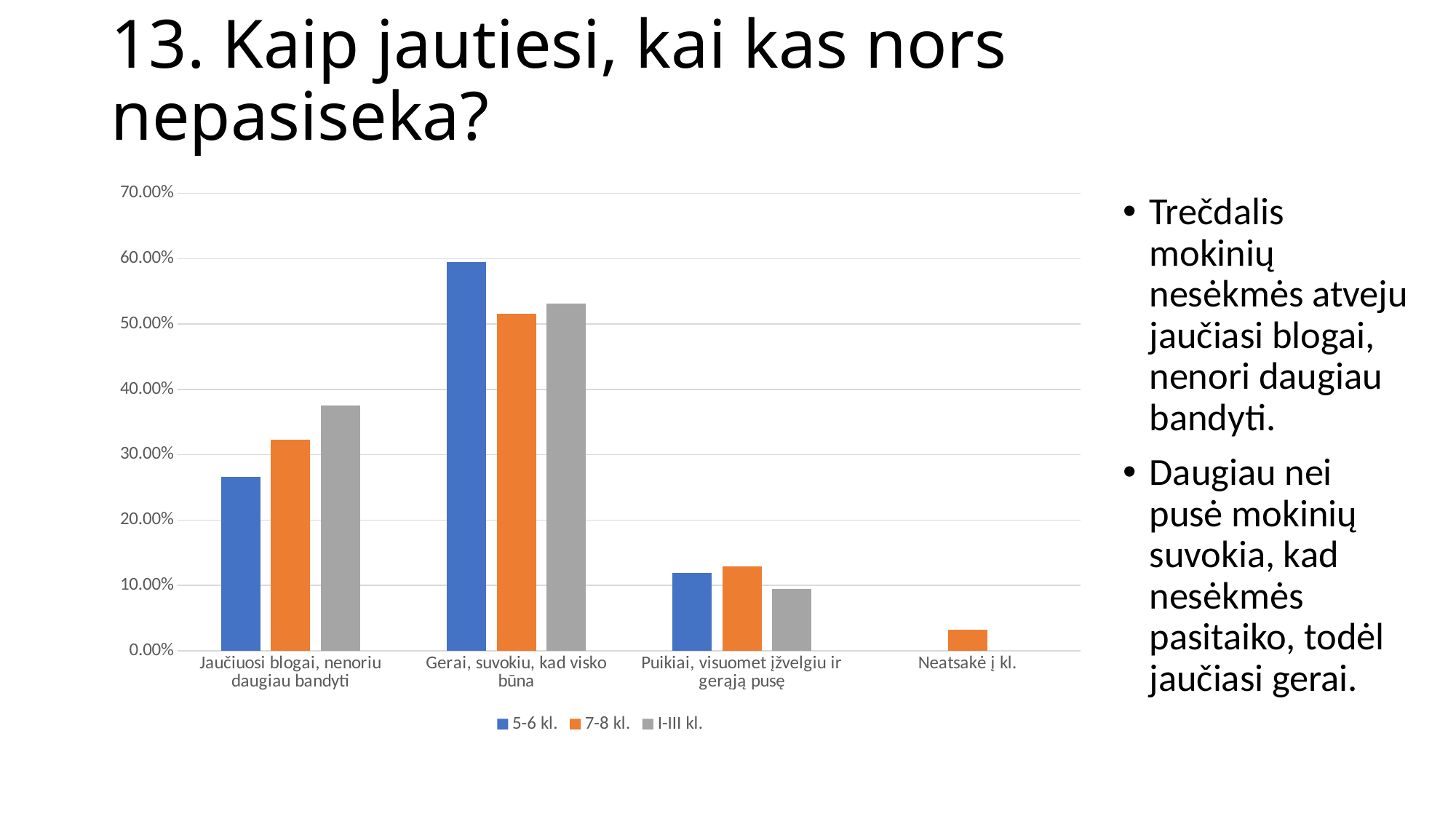
Is the value for 7-8 kl. in the category "Jaučiuosi blogai, nenoriu daugiau bandyti" greater or less than 30.00%? greater Is the value for I-III kl. in the category "Jaučiuosi blogai, nenoriu daugiau bandyti" greater or less than 40.00%? less How many series does the legend list? 3 How many categories are shown on the x axis? 4 Is the value for 5-6 kl. in the category "Gerai, suvokiu, kad visko būna" greater or less than 50.00%? greater In the category "Jaučiuosi blogai, nenoriu daugiau bandyti", which is larger: 5-6 kl. or I-III kl.? I-III kl. Which category has the highest value for the 5-6 kl. series? Gerai, suvokiu, kad visko būna What kind of chart is shown on the slide? bar chart Which series has the lowest value in the category "Puikiai, visuomet įžvelgiu ir gerąją pusę"? I-III kl. Which series is the only one with a bar in the category "Neatsakė į kl."? 7-8 kl. In the category "Gerai, suvokiu, kad visko būna", which is larger: 5-6 kl. or 7-8 kl.? 5-6 kl.